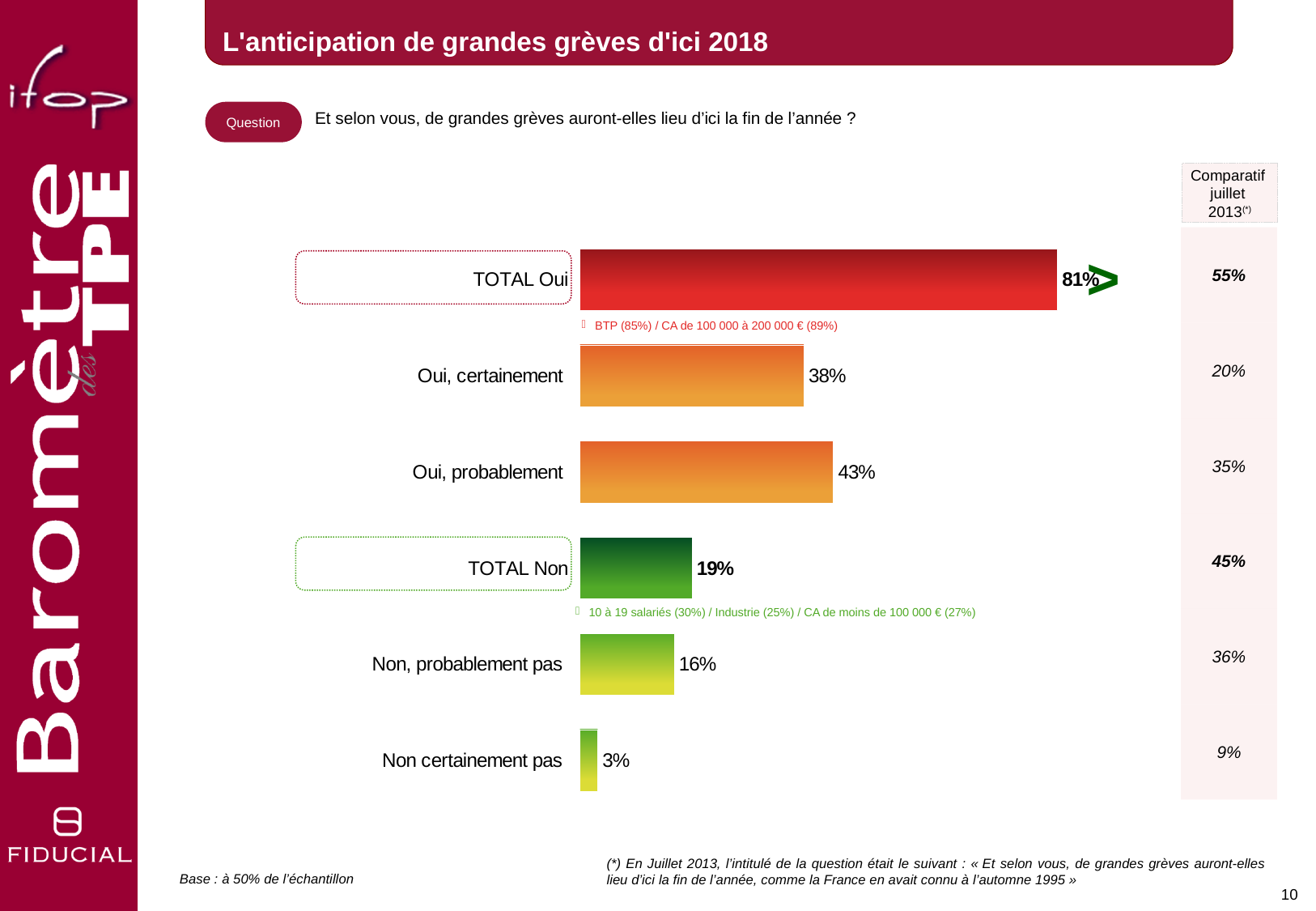
What kind of chart is shown on the slide? Bar chart What is the value shown for "Non certainement pas"? 3% What is the difference between the values for "Non, probablement pas" and "Non certainement pas"? 13% In the "Comparatif juillet 2013" column, what value is shown for "TOTAL Oui"? 55% Which category has the lowest value on the chart? Non certainement pas What is the difference between the values for "Oui, probablement" and "Oui, certainement"? 5% What is the title of the slide containing the chart? L'anticipation de grandes grèves d'ici 2018 What is the value shown for "TOTAL Oui"? 81% Which of the two sub-categories "Oui, certainement" and "Oui, probablement" has the higher value? Oui, probablement What is the value shown for "TOTAL Non"? 19% How many bars are plotted on the chart? 6 What is the value shown for "Oui, probablement"? 43%